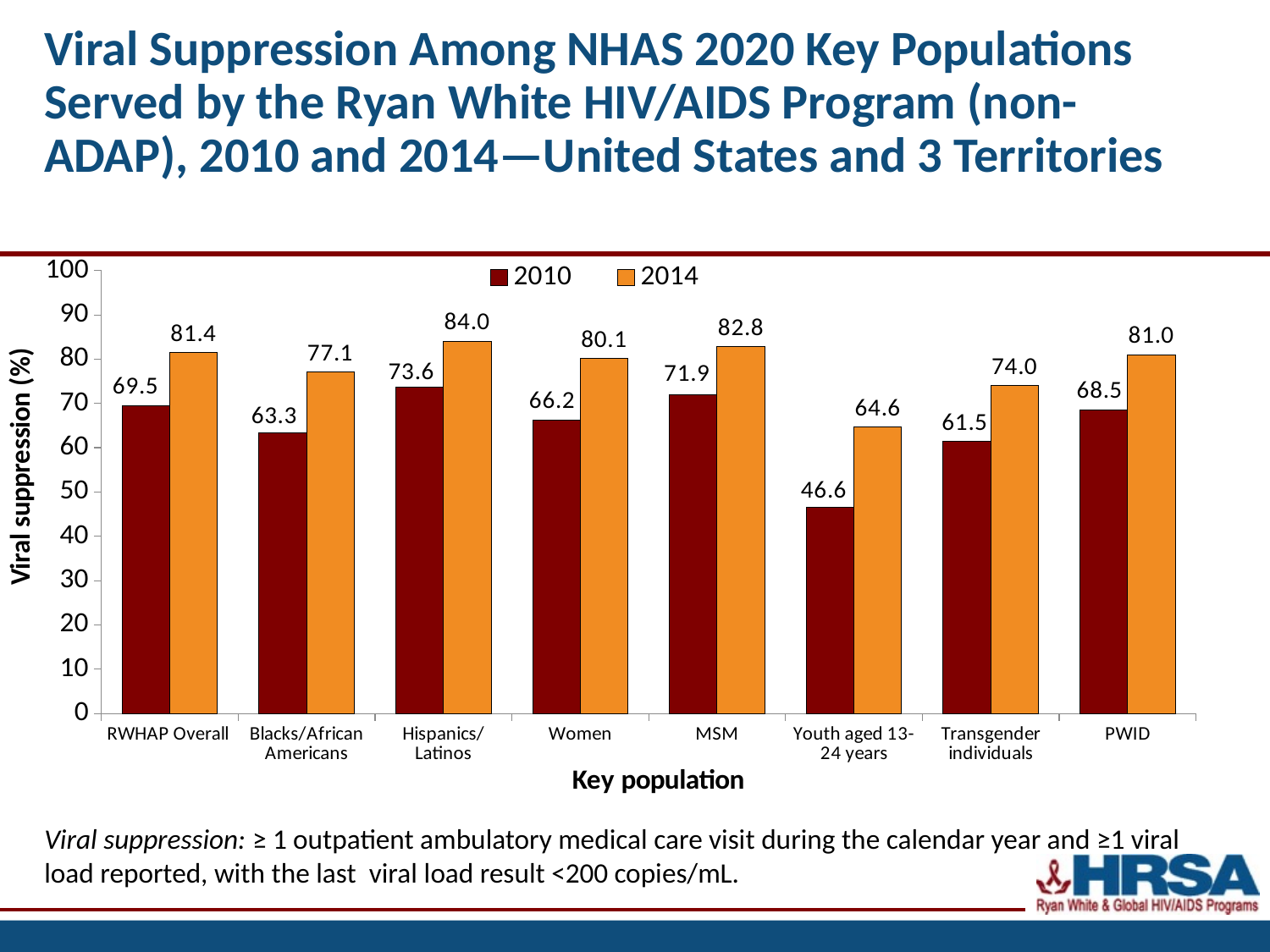
What is the label of the y axis? Viral suppression (%) How many series does the legend list? 2 What kind of chart is shown on the slide? Bar chart What was the viral suppression percentage for Transgender individuals in 2014? 74.0 Which key population had the highest viral suppression percentage in 2014? Hispanics/Latinos Which was higher in 2010: the viral suppression percentage for Women or for PWID? PWID What was the viral suppression percentage for Youth aged 13-24 years in 2010? 46.6 Which key population had the lowest viral suppression percentage in 2010? Youth aged 13-24 years How many key populations are shown on the x axis? 8 What is the difference between the 2014 and 2010 viral suppression percentages for Youth aged 13-24 years? 18.0 What was the viral suppression percentage for MSM in 2014? 82.8 What is the difference between the 2014 and 2010 viral suppression percentages for RWHAP Overall? 11.9